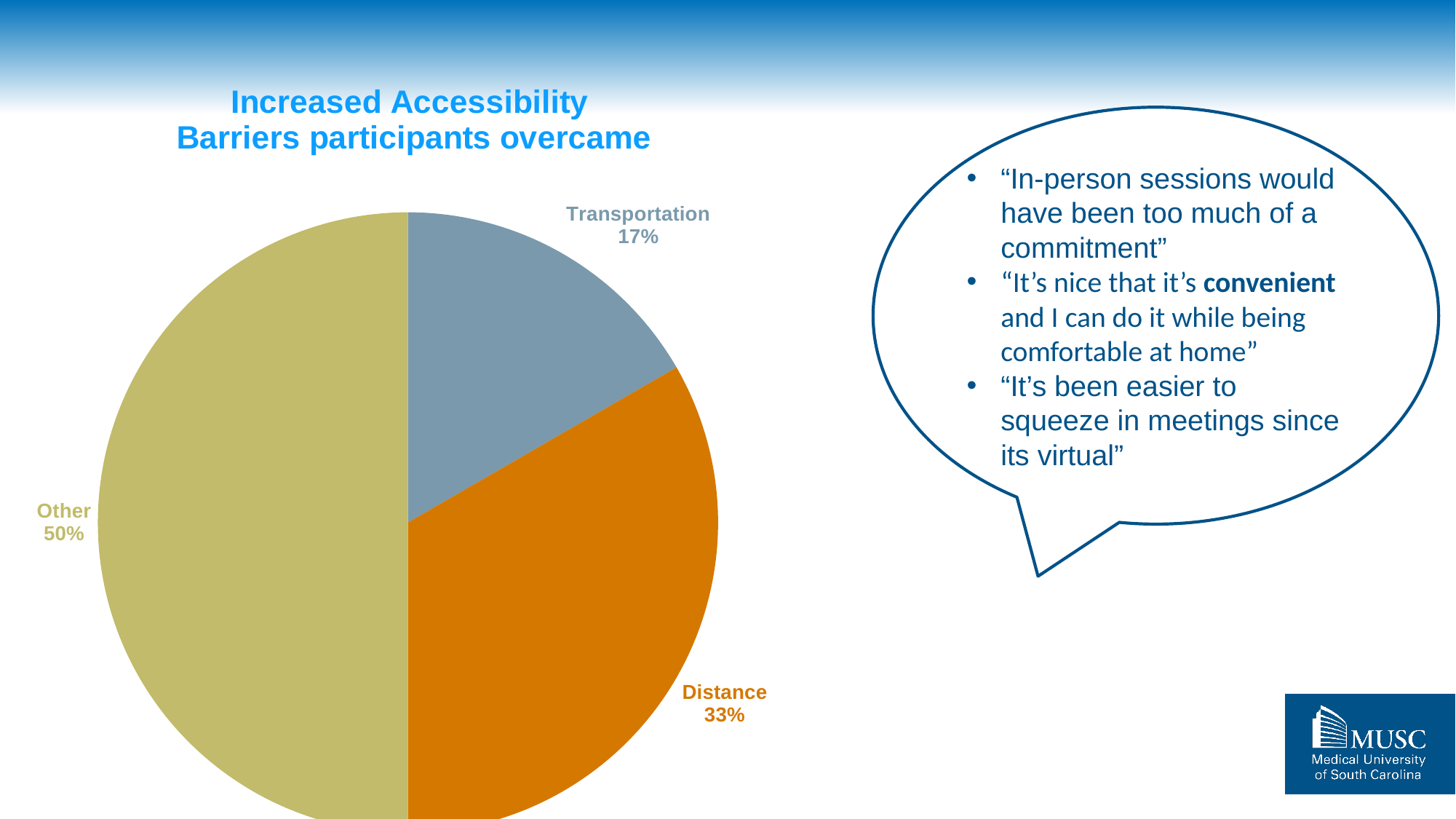
What kind of chart is shown on the slide? pie chart How many slices does the pie chart have? 3 What is the title of the chart? Increased Accessibility Barriers participants overcame What share of the pie does Transportation represent? 17% Which is larger, the Distance slice or the Transportation slice? Distance What is the difference in percentage points between Other and Distance? 17 What share of the pie does Distance represent? 33% Which category has the smallest slice of the pie? Transportation What colour is the Distance slice? orange What share of the pie does Other represent? 50% What is the difference in percentage points between Distance and Transportation? 16 Which category has the largest slice of the pie? Other